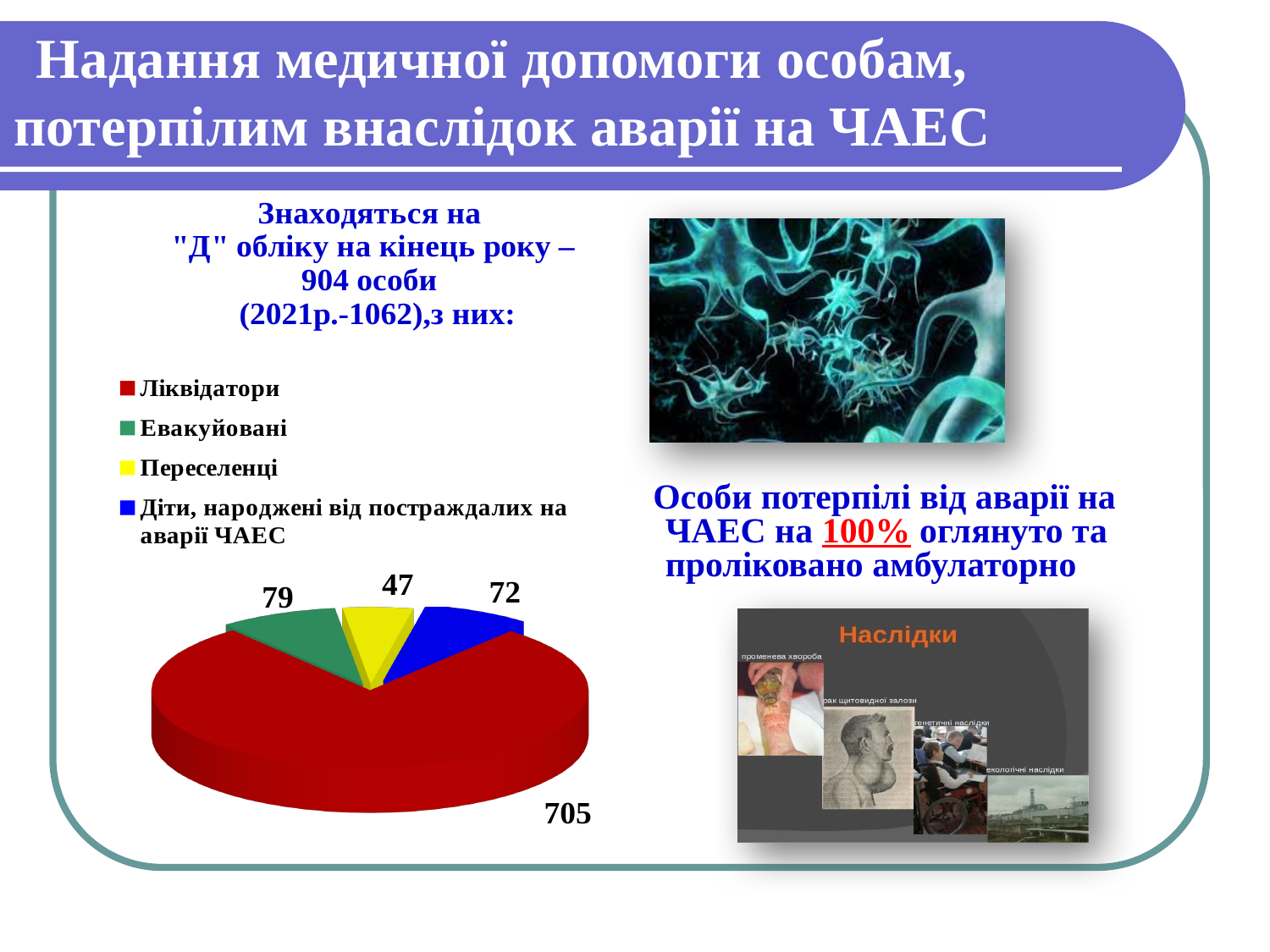
What is the value for Переселенці in the pie chart? 47 What is the value for Евакуйовані in the pie chart? 79 Which colour represents Переселенці in the pie chart? Yellow What is the difference between the values for Ліквідатори and Евакуйовані? 626 What type of chart is shown on the slide? Pie chart What is the difference between the values for Евакуйовані and Діти, народжені від постраждалих на аварії ЧАЕС? 7 Which is larger: the value for Переселенці or the value for Діти, народжені від постраждалих на аварії ЧАЕС? Діти, народжені від постраждалих на аварії ЧАЕС What is the value for Ліквідатори in the pie chart? 705 Which category has the smallest slice in the pie chart? Переселенці How many categories does the pie chart show? 4 What is the value for Діти, народжені від постраждалих на аварії ЧАЕС in the pie chart? 72 Which category has the largest slice in the pie chart? Ліквідатори